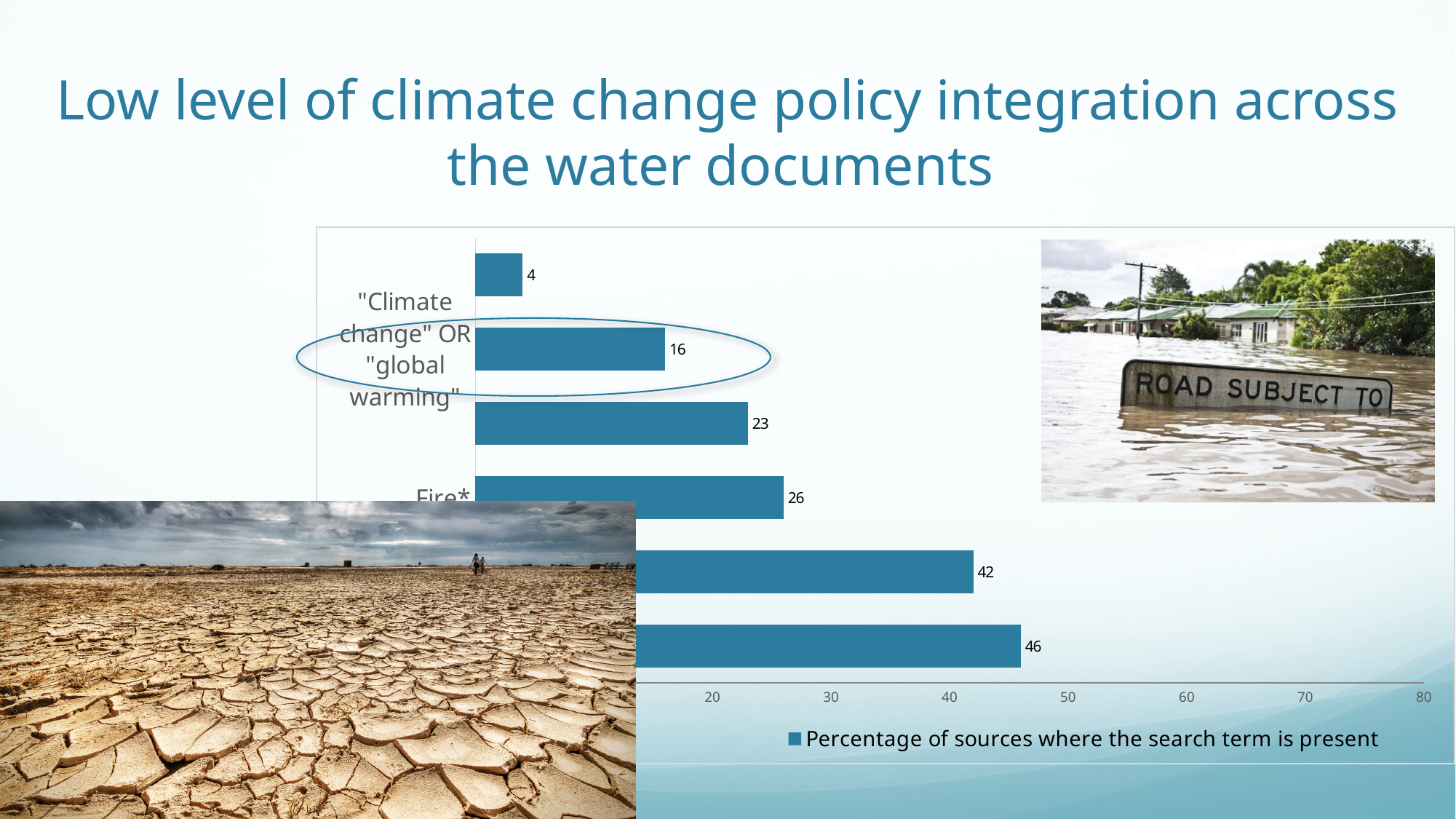
How many bars are plotted in the chart? 6 How many series does the legend list? 1 What type of chart is shown on the slide? bar chart What does the legend say the bars represent? Percentage of sources where the search term is present What is the value for "Climate change" OR "global warming"? 16 Which is larger: the value for "Climate change" OR "global warming" or the value for Fire*? Fire* What is the lowest value shown in the chart? 4 What is the difference between the value for Fire* and the bar labelled 23? 3 What is the value for Fire*? 26 What is the difference between the two longest bars (46 and 42)? 4 Is the value of the longest bar greater or less than 40? greater What is the highest value shown in the chart? 46